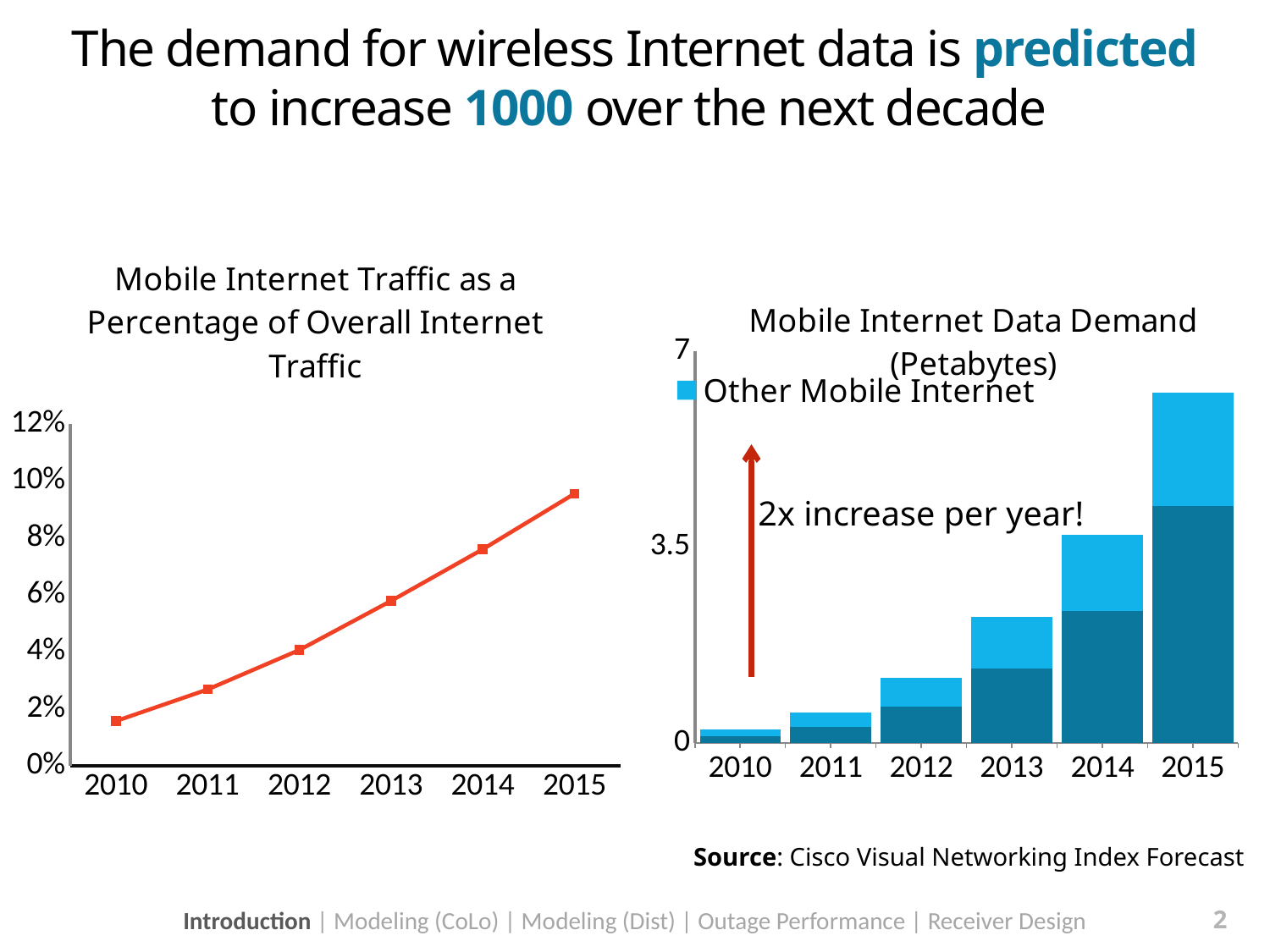
In the left chart, 'Mobile Internet Traffic as a Percentage of Overall Internet Traffic', how many years are plotted on the x axis? 6 In the right chart, 'Mobile Internet Data Demand (Petabytes)', how many years are shown on the x axis? 6 In the left chart, 'Mobile Internet Traffic as a Percentage of Overall Internet Traffic', is the value for 2015 greater or less than 8%? greater What kind of chart is the 'Mobile Internet Traffic as a Percentage of Overall Internet Traffic' chart on the left? line chart In the left chart, 'Mobile Internet Traffic as a Percentage of Overall Internet Traffic', is the value for 2010 greater or less than 2%? less In the left chart, 'Mobile Internet Traffic as a Percentage of Overall Internet Traffic', which is larger, the value for 2014 or the value for 2012? 2014 In the right chart, 'Mobile Internet Data Demand (Petabytes)', what legend entry is shown for the light blue series? Other Mobile Internet In the right chart, 'Mobile Internet Data Demand (Petabytes)', which year has the tallest bar? 2015 In the left chart, 'Mobile Internet Traffic as a Percentage of Overall Internet Traffic', do the values rise or fall from 2010 to 2015? rise In the right chart, 'Mobile Internet Data Demand (Petabytes)', is the total bar height for 2013 greater or less than 3.5? less What kind of chart is the 'Mobile Internet Data Demand (Petabytes)' chart on the right? bar chart In the left chart, 'Mobile Internet Traffic as a Percentage of Overall Internet Traffic', which year has the lowest value? 2010